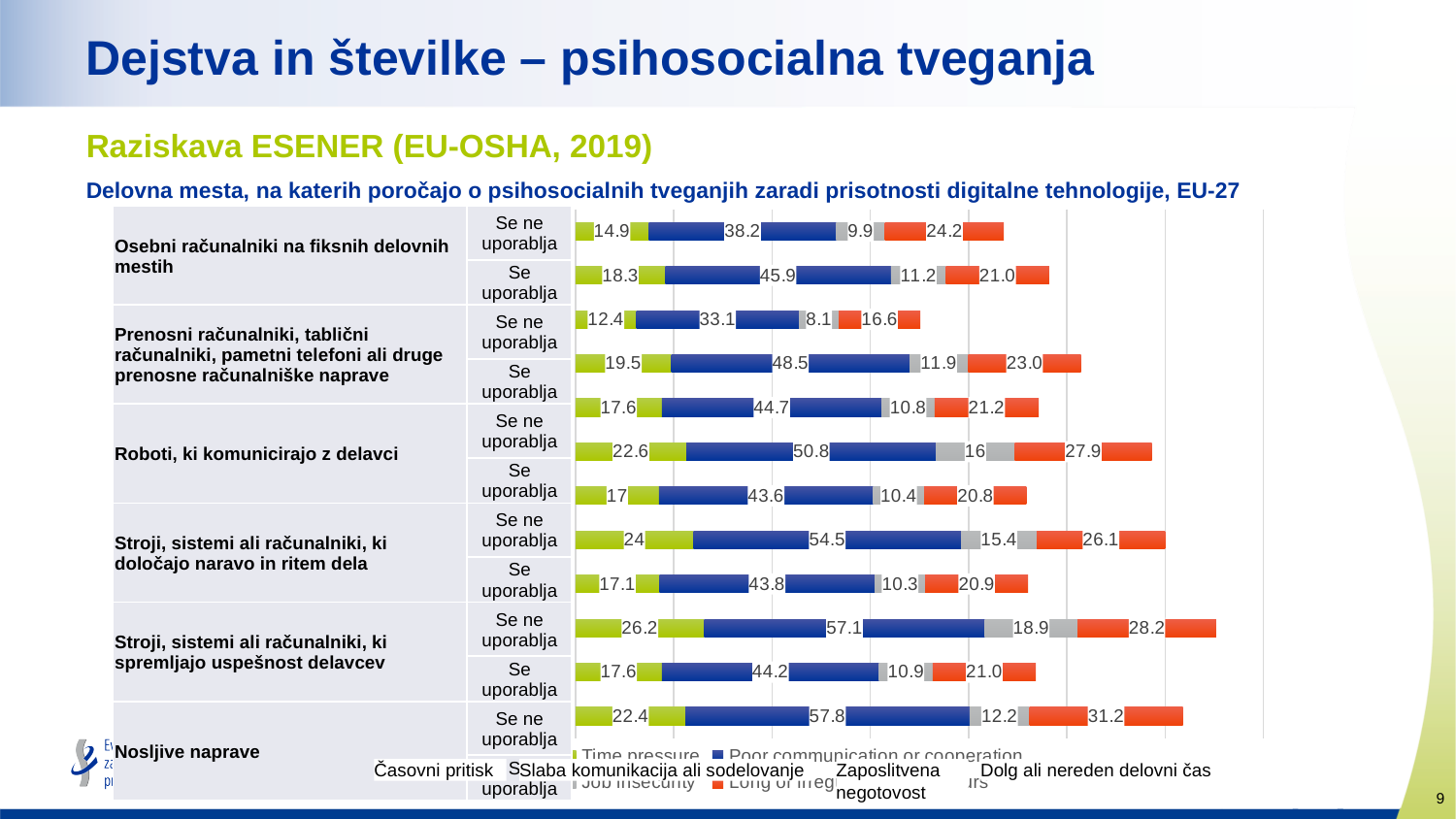
What is the Long or irregular working hours value in the bottommost bar (Nosljive naprave, Se uporablja)? 31.2 What is the total of the topmost stacked bar (Osebni računalniki na fiksnih delovnih mestih, Se ne uporablja)? 87.2 What is the highest Poor communication or cooperation value shown in any bar? 57.8 Which is larger: the Time pressure value in the topmost bar (14.9) or in the bottommost bar (22.4)? Bottommost bar (22.4) How many series does the chart legend list? 4 What is the Poor communication or cooperation value in the topmost bar (Osebni računalniki na fiksnih delovnih mestih, Se ne uporablja)? 38.2 What is the difference between the Long or irregular working hours values in the bottommost bar (31.2) and the topmost bar (24.2)? 7 What is the lowest Job insecurity value shown in any bar? 8.1 What is the total of the bottommost stacked bar (Nosljive naprave, Se uporablja)? 123.6 What is the Time pressure value in the topmost bar (Osebni računalniki na fiksnih delovnih mestih, Se ne uporablja)? 14.9 How many stacked bars are plotted in the chart? 12 What kind of chart is shown on the slide? Stacked bar chart